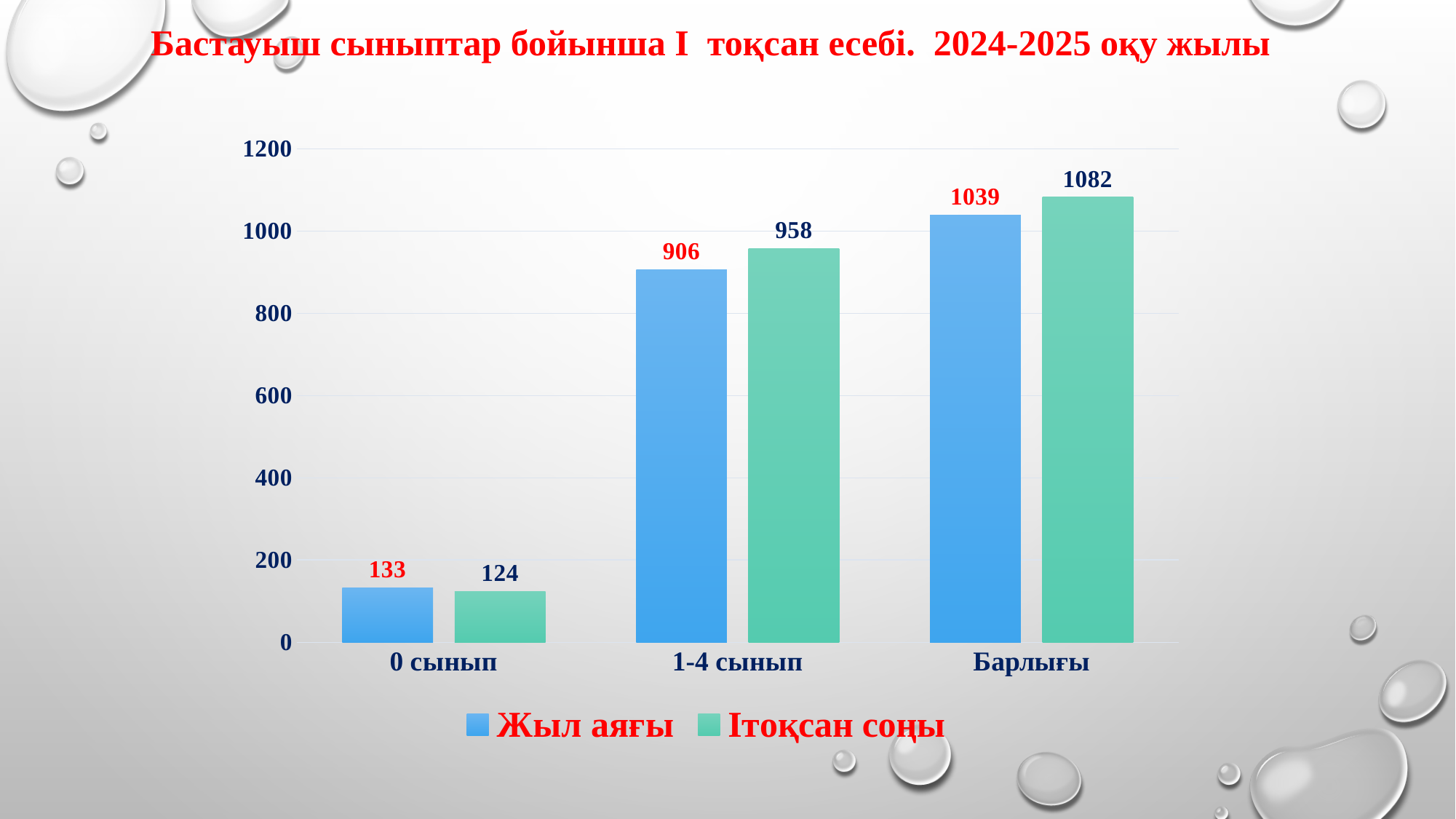
What is the value for "Жыл аяғы" in the "Барлығы" category? 1039 What is the difference between "Ітоқсан соңы" and "Жыл аяғы" in the "Барлығы" category? 43 What kind of chart is shown on the slide? bar chart What is the difference between "Жыл аяғы" and "Ітоқсан соңы" in the "0 сынып" category? 9 What is the value for "Ітоқсан соңы" in the "1-4 сынып" category? 958 Which category has the lowest value for the "Жыл аяғы" series? 0 сынып In the "1-4 сынып" category, which series has the larger value, "Жыл аяғы" or "Ітоқсан соңы"? Ітоқсан соңы What is the value for "Жыл аяғы" in the "0 сынып" category? 133 How many series does the legend list? 2 Which category has the highest value for the "Ітоқсан соңы" series? Барлығы Is the value for "Жыл аяғы" in the "1-4 сынып" category greater or less than 1000? less How many categories are shown on the x axis? 3